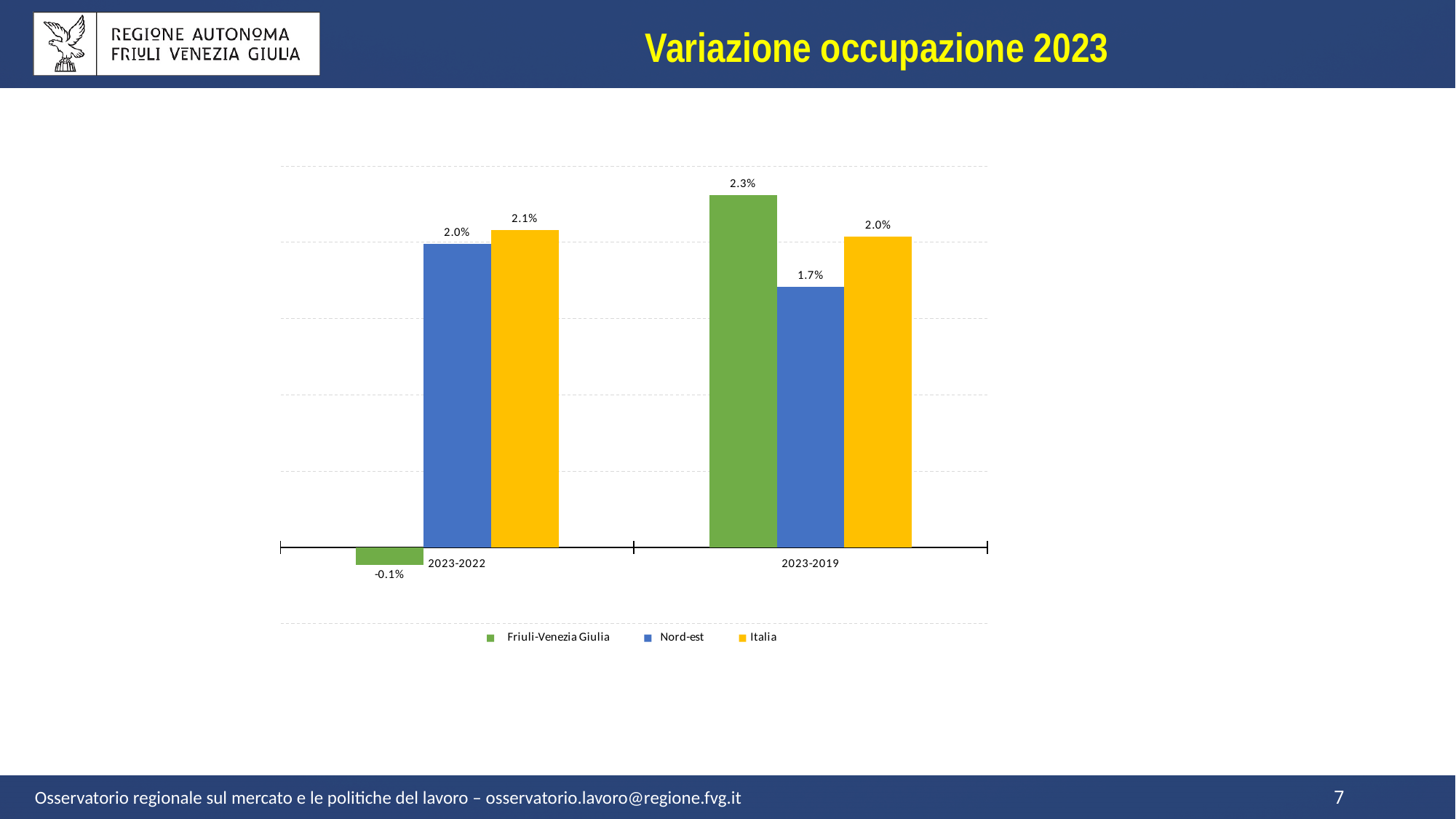
What colour represents Italia in the chart? Yellow What kind of chart is shown on the slide? Bar chart What is the difference between the Friuli-Venezia Giulia and Nord-est values in 2023-2019? 0.6% What is the value for Nord-est in 2023-2019? 1.7% What is the value for Italia in 2023-2022? 2.1% What is the value for Friuli-Venezia Giulia in 2023-2022? -0.1% How many series does the legend list? 3 Which series has the lowest value in 2023-2022? Friuli-Venezia Giulia How many categories are shown on the x axis? 2 Which series has the highest value in 2023-2019? Friuli-Venezia Giulia Which is larger in 2023-2022: the value for Nord-est or the value for Italia? Italia What is the value for Friuli-Venezia Giulia in 2023-2019? 2.3%